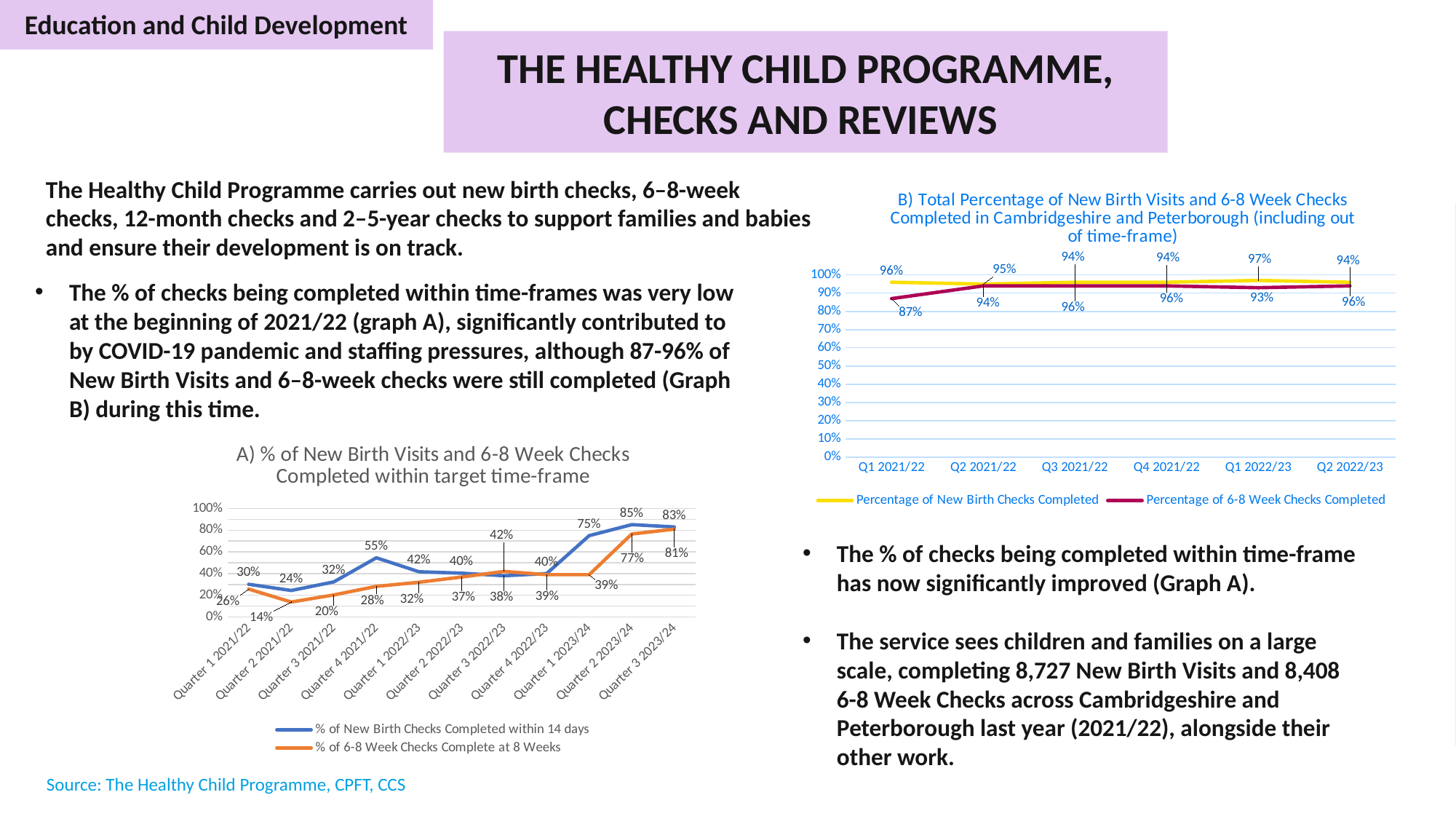
In chart A, which quarter has the highest value for % of New Birth Checks Completed within 14 days? Quarter 2 2023/24 In chart B (Total Percentage of New Birth Visits and 6-8 Week Checks Completed), what is the Percentage of 6-8 Week Checks Completed in Q1 2021/22? 87% What type of chart is chart B? line chart In chart A, what is the value of % of 6-8 Week Checks Complete at 8 Weeks in Quarter 2 2021/22? 14% In chart B, how many series does the legend list? 2 In chart A (% of New Birth Visits and 6-8 Week Checks Completed within target time-frame), what is the value of % of New Birth Checks Completed within 14 days in Quarter 4 2021/22? 55% In chart A, does the % of 6-8 Week Checks Complete at 8 Weeks generally rise or fall from Quarter 2 2021/22 to Quarter 3 2023/24? rise In chart B, what is the Percentage of New Birth Checks Completed in Q1 2022/23? 97% In chart A, which quarter has the lowest value for % of 6-8 Week Checks Complete at 8 Weeks? Quarter 2 2021/22 In chart B, which is larger in Q1 2021/22: Percentage of New Birth Checks Completed or Percentage of 6-8 Week Checks Completed? Percentage of New Birth Checks Completed In chart A, how many quarters are plotted on the x axis? 11 In chart A, what is the difference between % of New Birth Checks Completed within 14 days and % of 6-8 Week Checks Complete at 8 Weeks in Quarter 1 2023/24? 36%